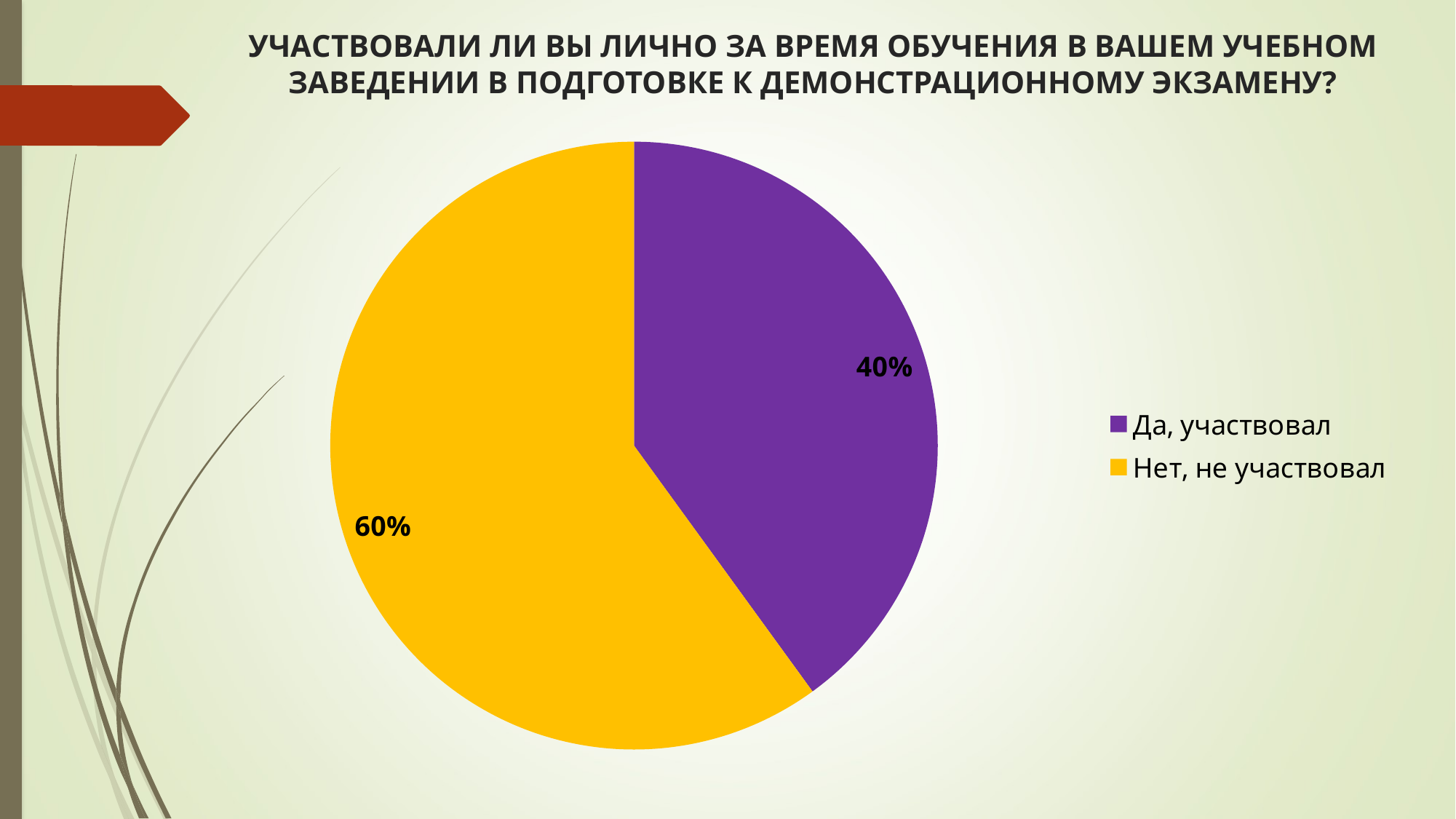
What share of the pie does the "Да, участвовал" slice represent? 40% What percentage of respondents answered "Да, участвовал"? 40% What colour is the slice for "Нет, не участвовал"? yellow Which answer has the smallest share of the pie? Да, участвовал Which is larger: the share for "Да, участвовал" or the share for "Нет, не участвовал"? Нет, не участвовал Which answer has the largest share of the pie? Нет, не участвовал How many slices does the pie chart have? 2 What is the difference in percentage points between "Нет, не участвовал" and "Да, участвовал"? 20 What colour is the slice for "Да, участвовал"? purple What kind of chart is shown on the slide? pie chart What percentage of respondents answered "Нет, не участвовал"? 60% How many entries does the legend list? 2